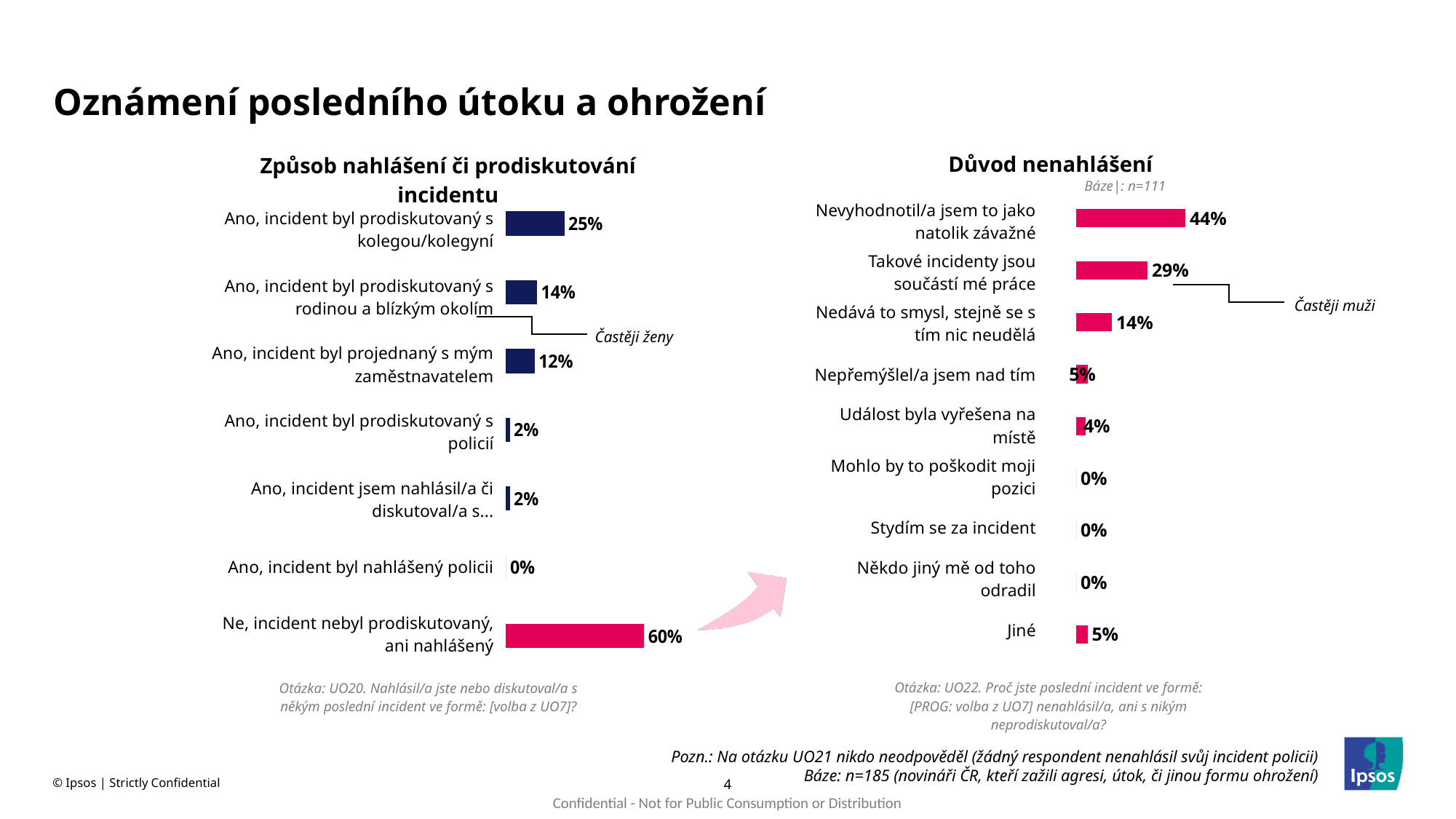
In the chart 'Důvod nenahlášení', which is larger: 'Nedává to smysl, stejně se s tím nic neudělá' or 'Jiné'? Nedává to smysl, stejně se s tím nic neudělá In the chart 'Důvod nenahlášení', what is the value for 'Nevyhodnotil/a jsem to jako natolik závažné'? 44% In the chart 'Způsob nahlášení či prodiskutování incidentu', how many categories are shown? 7 In the chart 'Způsob nahlášení či prodiskutování incidentu', what is the value for 'Ne, incident nebyl prodiskutovaný, ani nahlášený'? 60% In the chart 'Důvod nenahlášení', how many categories are shown? 9 In the chart 'Způsob nahlášení či prodiskutování incidentu', what is the value for 'Ano, incident byl nahlášený policii'? 0% What type of chart is 'Důvod nenahlášení'? Bar chart In the chart 'Způsob nahlášení či prodiskutování incidentu', what is the value for 'Ano, incident byl prodiskutovaný s kolegou/kolegyní'? 25% In the chart 'Důvod nenahlášení', what is the value for 'Takové incidenty jsou součástí mé práce'? 29% In the chart 'Důvod nenahlášení', which category has the highest value? Nevyhodnotil/a jsem to jako natolik závažné In the chart 'Způsob nahlášení či prodiskutování incidentu', which category has the highest value? Ne, incident nebyl prodiskutovaný, ani nahlášený In the chart 'Způsob nahlášení či prodiskutování incidentu', what is the difference between 'Ano, incident byl prodiskutovaný s kolegou/kolegyní' and 'Ano, incident byl prodiskutovaný s rodinou a blízkým okolím'? 11%